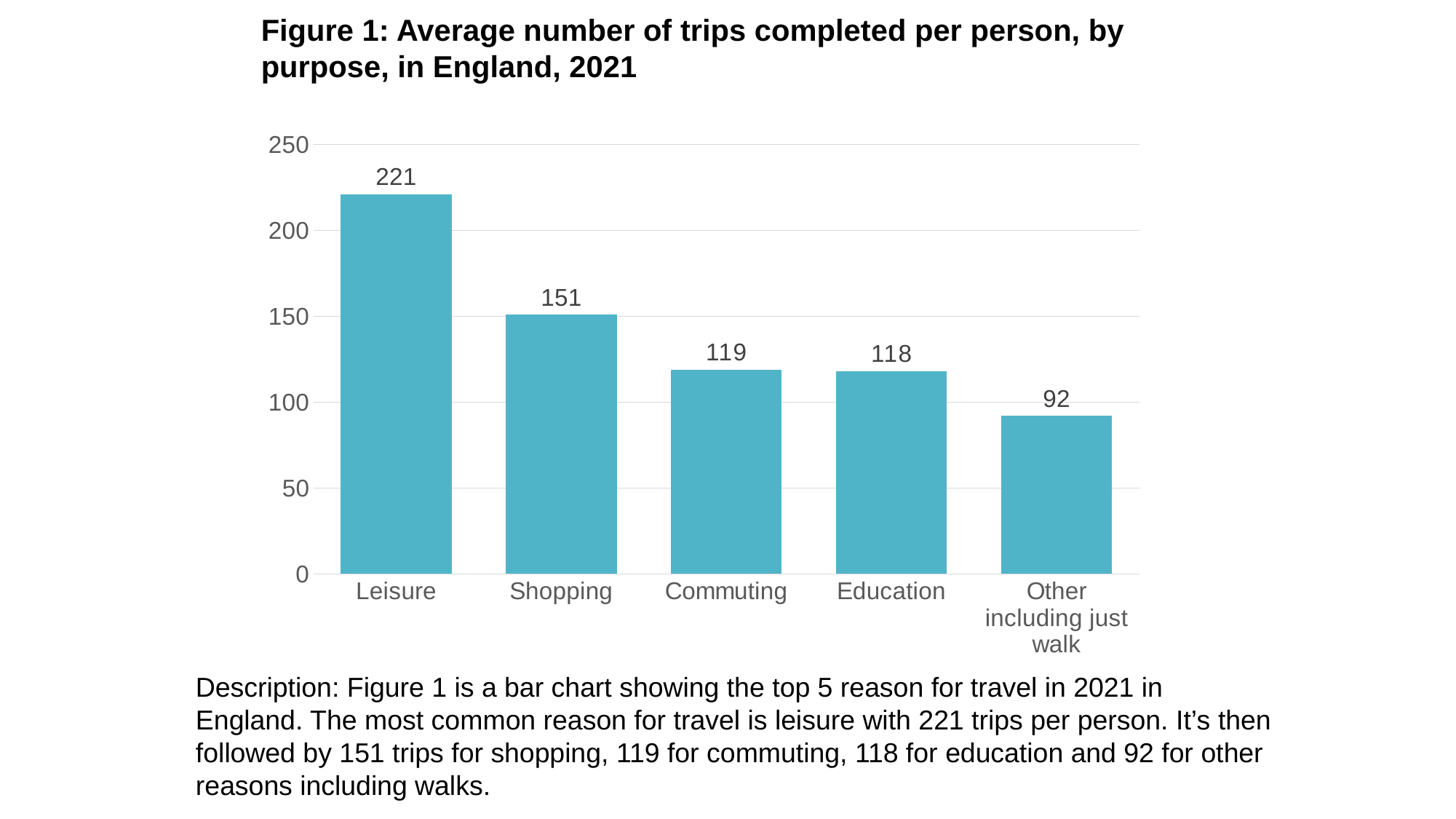
What is the difference between the number of trips for Leisure and Shopping? 70 What is the average number of trips per person for Other including just walk? 92 Which purpose has the highest average number of trips per person? Leisure What is the average number of trips per person for Leisure? 221 Do the values rise or fall moving from left to right across the categories? Fall What is the average number of trips per person for Shopping? 151 What kind of chart is shown on the slide? Bar chart How many purpose categories are shown in the chart? 5 What is the average number of trips per person for Commuting? 119 What is the difference between the number of trips for Commuting and Education? 1 Which purpose has the lowest average number of trips per person? Other including just walk Which has more trips per person, Shopping or Education? Shopping